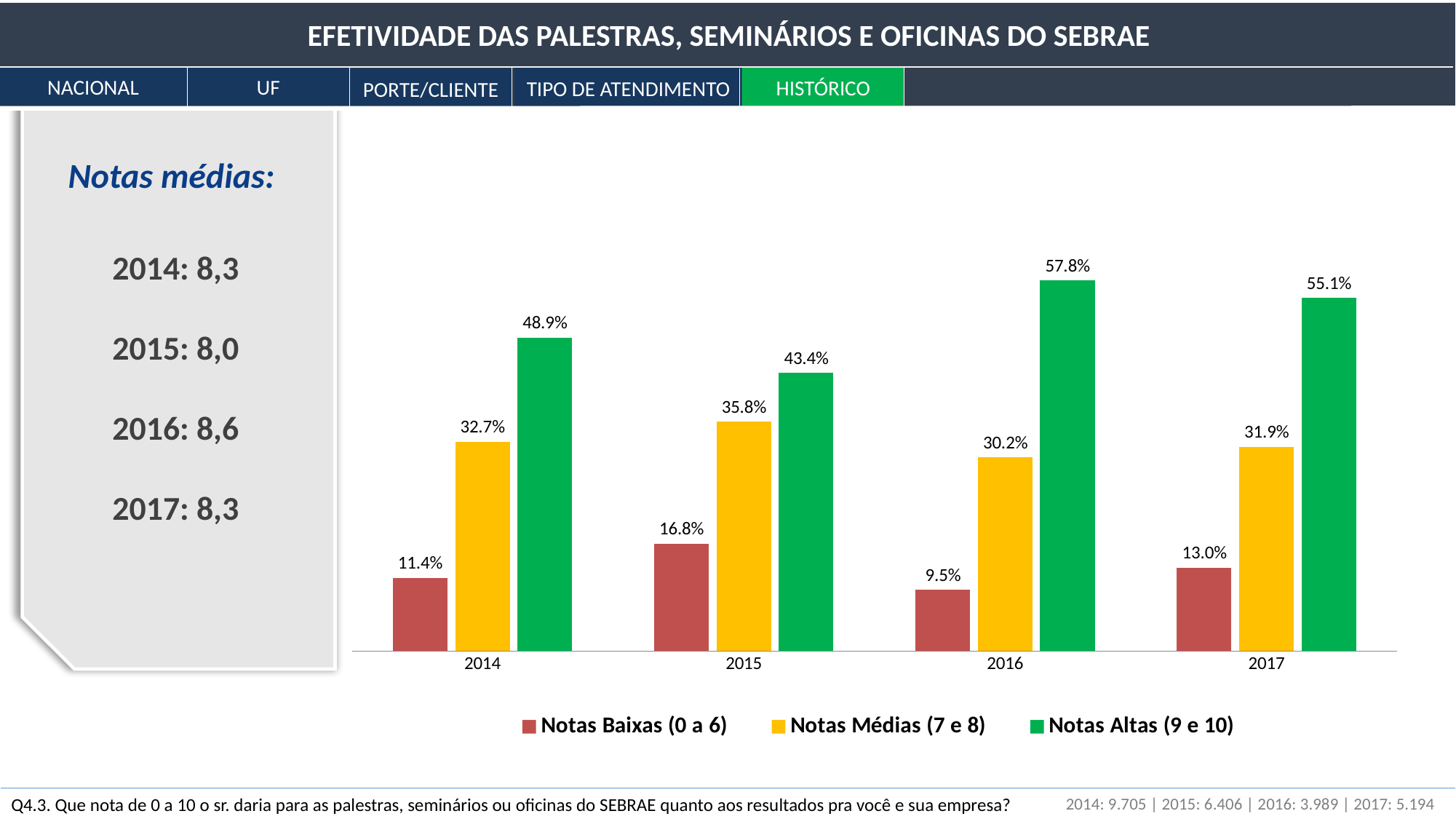
What is the difference between the Notas Altas (9 e 10) values for 2016 and 2014? 8.9% In which year is the Notas Baixas (0 a 6) value lowest? 2016 What colour represents Notas Altas (9 e 10) in the legend? Green Does the Notas Médias (7 e 8) value rise or fall from 2015 to 2016? Fall How many years are shown on the x axis? 4 Which is larger: Notas Médias (7 e 8) in 2014 or in 2015? 2015 What kind of chart is shown? Bar chart What is the value for Notas Baixas (0 a 6) in 2015? 16.8% In which year is the Notas Altas (9 e 10) value highest? 2016 What is the value for Notas Altas (9 e 10) in 2016? 57.8% How many series does the legend list? 3 What is the value for Notas Médias (7 e 8) in 2017? 31.9%